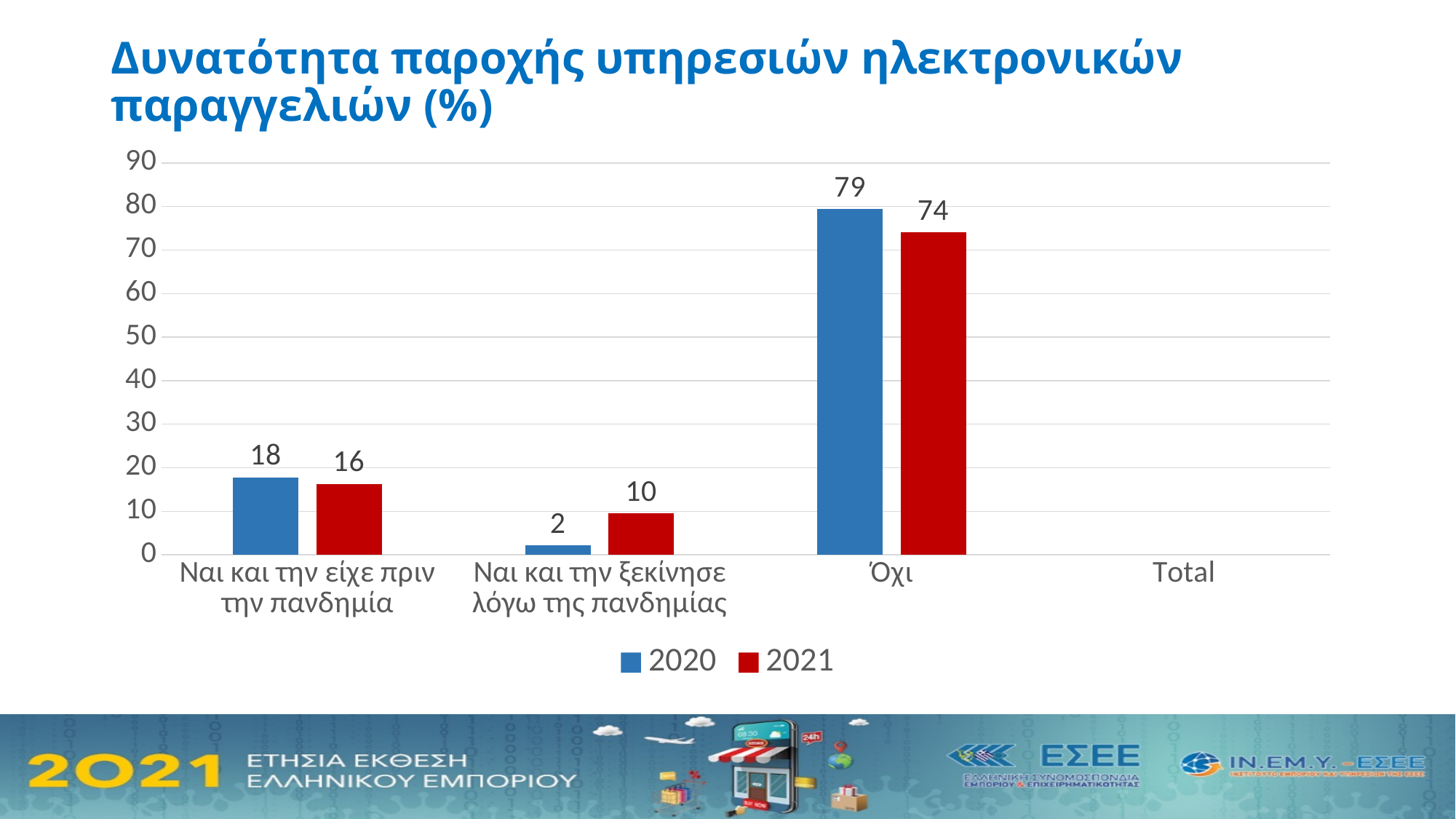
Which colour represents the 2021 series? red What is the 2021 value for "Ναι και την είχε πριν την πανδημία"? 16 What is the 2021 value for "Ναι και την ξεκίνησε λόγω της πανδημίας"? 10 What is the 2020 value for "Όχι"? 79 What kind of chart is shown on the slide? bar chart Which category has the lowest 2020 value? Ναι και την ξεκίνησε λόγω της πανδημίας Which category has the highest 2021 value? Όχι What is the 2020 value for "Ναι και την ξεκίνησε λόγω της πανδημίας"? 2 How many series does the legend list? 2 Is the 2021 value for "Όχι" greater or less than 70? greater For "Ναι και την ξεκίνησε λόγω της πανδημίας", which year has the larger value, 2020 or 2021? 2021 What is the difference between the 2020 and 2021 values for "Όχι"? 5